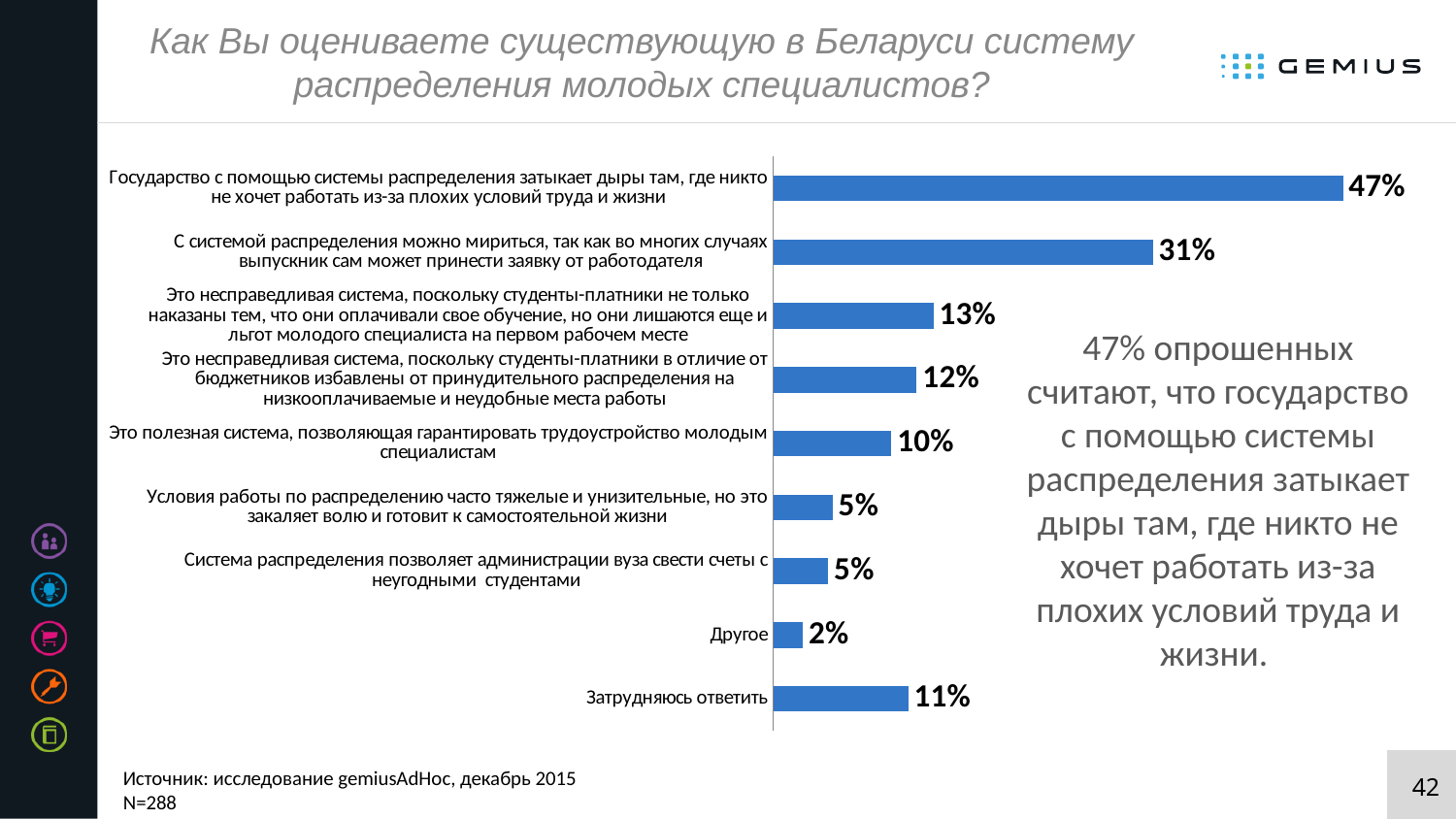
Which response option has the highest value? Государство с помощью системы распределения затыкает дыры там, где никто не хочет работать из-за плохих условий труда и жизни What is the sample size (N) stated on the slide? N=288 What is the difference between the top answer (47%) and the second answer ("С системой распределения можно мириться...")? 16 percentage points Which is larger: the value for "Затрудняюсь ответить" or the value for "Это полезная система, позволяющая гарантировать трудоустройство молодым специалистам"? Затрудняюсь ответить What is the value for "Затрудняюсь ответить"? 11% What type of chart is shown on the slide? Bar chart What colour are the bars in the chart? Blue How many response categories are shown in the chart? 9 Which response option has the lowest value? Другое What is the value for "Условия работы по распределению часто тяжелые и унизительные, но это закаляет волю и готовит к самостоятельной жизни"? 5% What percentage of respondents chose "Другое"? 2% What share of respondents said the distribution system is a useful system that guarantees employment for young specialists ("Это полезная система...")? 10%